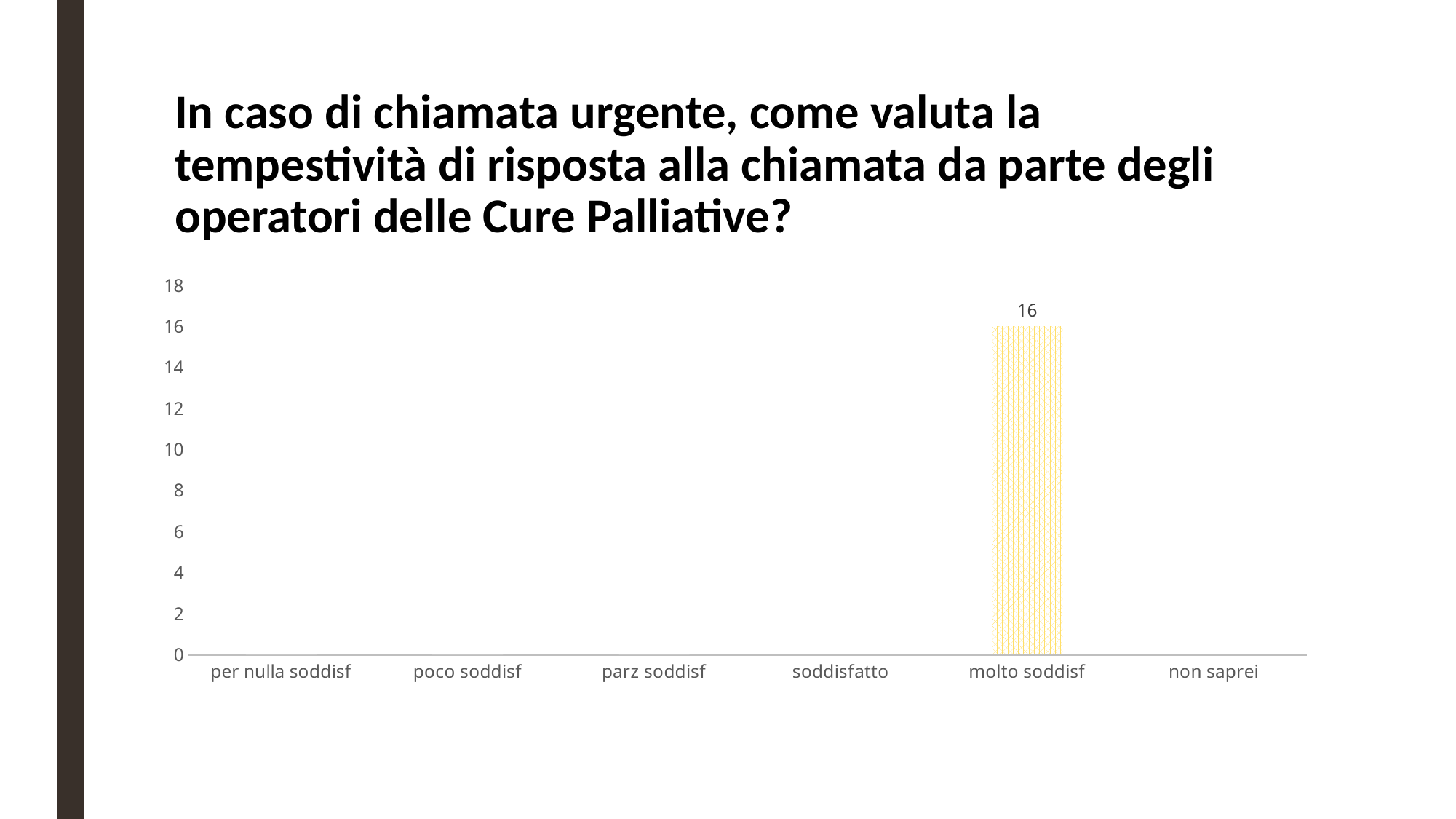
What is the highest tick value shown on the vertical axis? 18 What is the label of the fifth category on the x axis? molto soddisf What is the value for "molto soddisf"? 16 Which category has the highest value? molto soddisf How many categories are shown on the x axis? 6 Is the value for "molto soddisf" greater or less than 10? greater Is the value for "per nulla soddisf" greater or less than 10? less Which is larger, the value for "molto soddisf" or the value for "soddisfatto"? molto soddisf What kind of chart is shown on the slide? bar chart Is the value for "non saprei" greater or less than 4? less